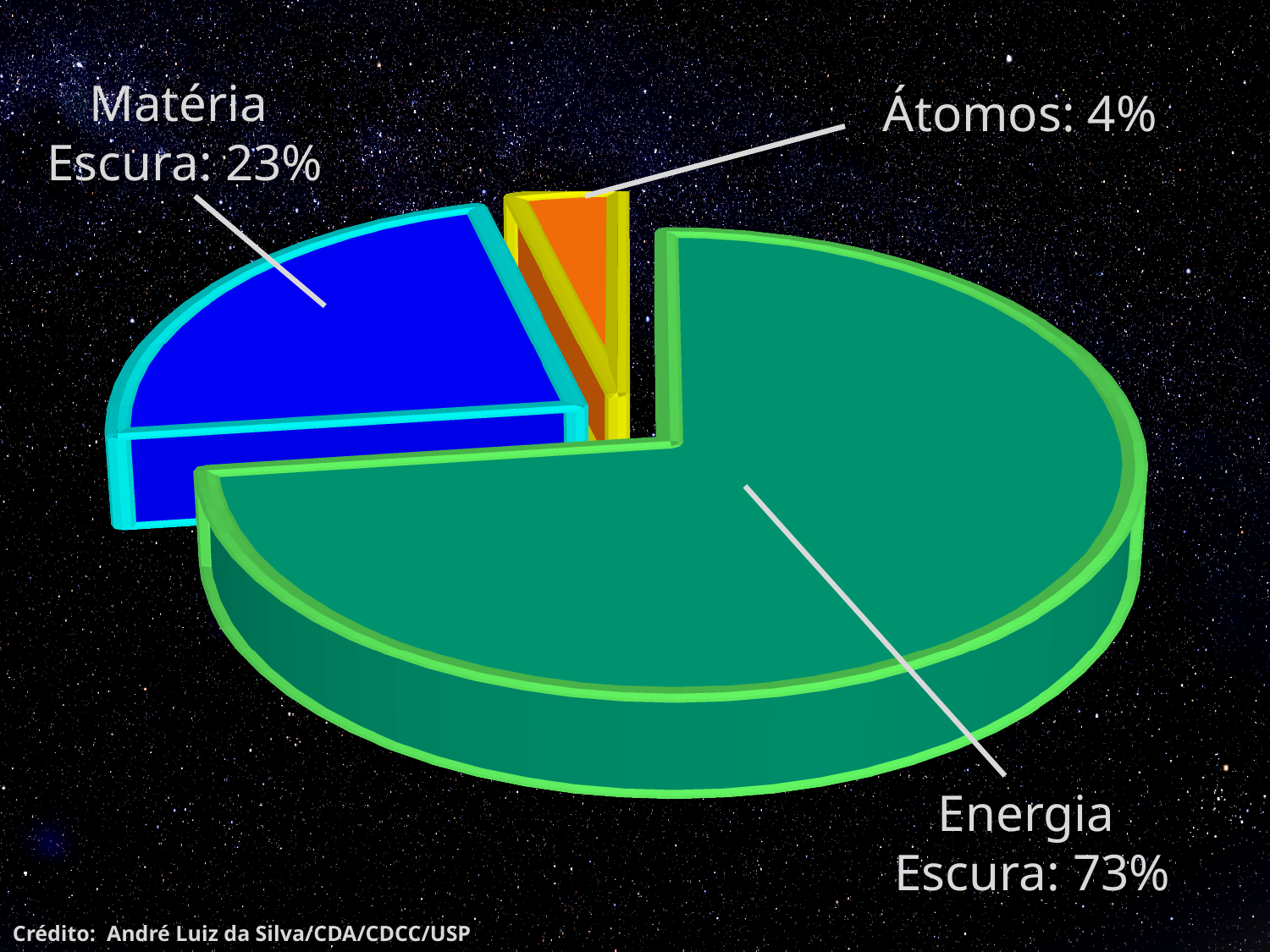
What share of the pie is labelled Matéria Escura? 23% What share of the pie is labelled Energia Escura? 73% What is the difference in percentage points between Matéria Escura and Átomos? 19 What share of the pie is labelled Átomos? 4% What kind of chart is shown on the slide? pie chart Which slice of the pie is the smallest? Átomos Which slice of the pie is the largest? Energia Escura How many slices does the pie chart have? 3 What is the difference in percentage points between Energia Escura and Matéria Escura? 50 What colour is the Energia Escura slice? green What colour is the Matéria Escura slice? blue Which is larger, the share for Matéria Escura or the share for Átomos? Matéria Escura